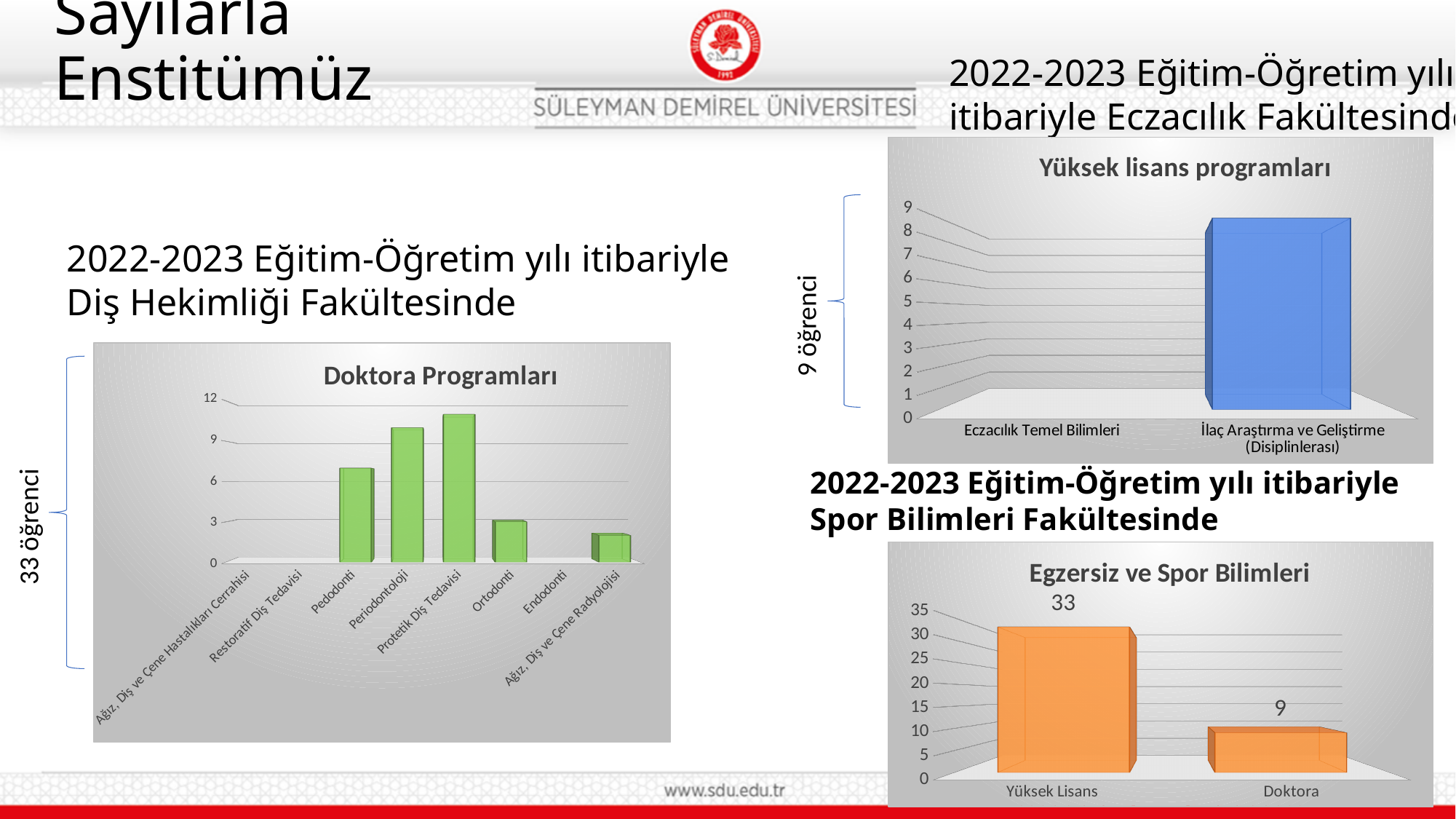
In the 'Egzersiz ve Spor Bilimleri' chart, what is the value for Yüksek Lisans? 33 What kind of chart is the 'Egzersiz ve Spor Bilimleri' chart? Bar chart In the 'Yüksek lisans programları' chart, is the value for İlaç Araştırma ve Geliştirme (Disiplinlerası) greater or less than 5? greater In the 'Egzersiz ve Spor Bilimleri' chart, which category has the higher value? Yüksek Lisans How many categories are shown on the x axis of the 'Doktora Programları' chart? 8 In the 'Doktora Programları' chart, is the value for Ortodonti greater or less than 6? less In the 'Doktora Programları' chart, is the value for Pedodonti greater or less than 6? greater In the 'Doktora Programları' chart, which category has the highest value? Protetik Diş Tedavisi In the 'Egzersiz ve Spor Bilimleri' chart, what is the value for Doktora? 9 How many categories are shown on the x axis of the 'Yüksek lisans programları' chart? 2 In the 'Egzersiz ve Spor Bilimleri' chart, what is the difference between the Yüksek Lisans and Doktora values? 24 In the 'Doktora Programları' chart, which is larger: the value for Periodontoloji or the value for Ortodonti? Periodontoloji